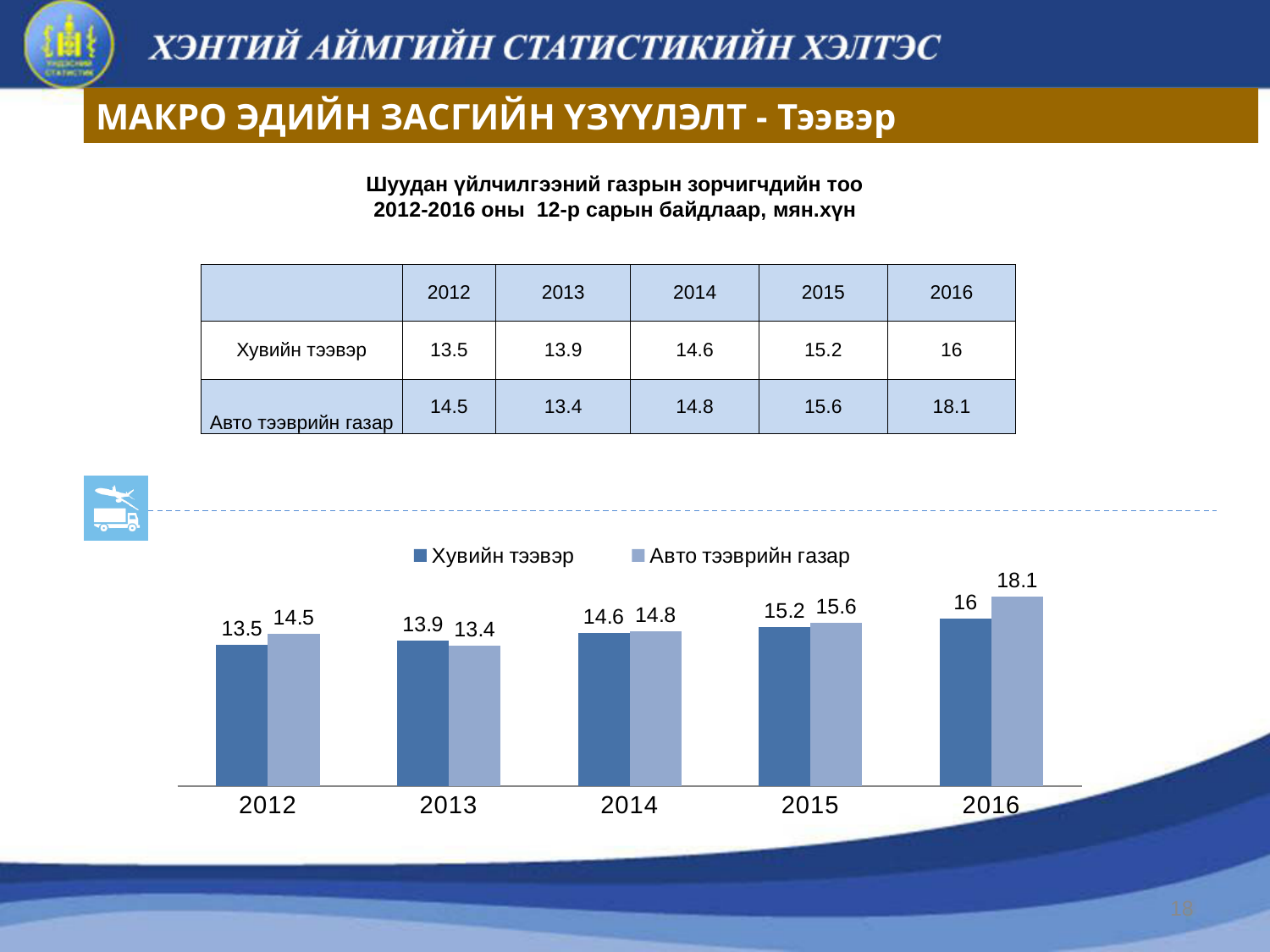
What is the value for Авто тээврийн газар in 2016? 18.1 How many series does the chart legend list? 2 In which year is the Авто тээврийн газар value highest? 2016 Which is larger in 2013, Хувийн тээвэр or Авто тээврийн газар? Хувийн тээвэр What is the value for Хувийн тээвэр in 2014? 14.6 What kind of chart is shown on the slide? Bar chart How many years are shown on the x axis of the chart? 5 What is the difference between the Авто тээврийн газар and Хувийн тээвэр values in 2016? 2.1 What is the value for Авто тээврийн газар in 2013? 13.4 Which series is shown in the darker blue colour in the chart? Хувийн тээвэр Does the Хувийн тээвэр value rise or fall from 2012 to 2016? Rise In which year is the Хувийн тээвэр value lowest? 2012